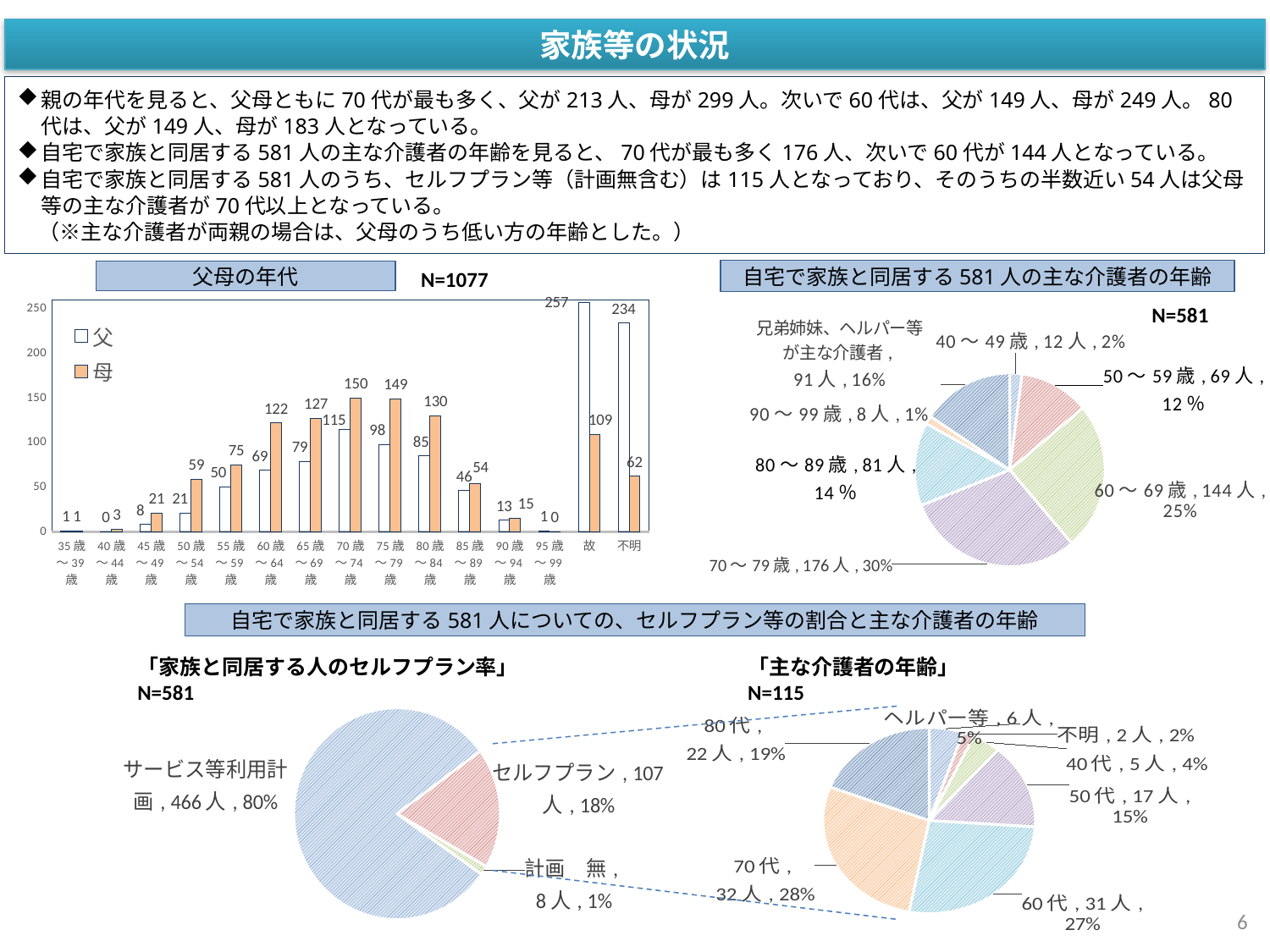
「自宅で家族と同居する581人の主な介護者の年齢」の円グラフで、80～89歳の人数はいくつですか？ 81人 「自宅で家族と同居する581人の主な介護者の年齢」の円グラフで、最も割合が大きい区分はどれですか？ 70～79歳 「父母の年代」のグラフはどの種類のグラフですか？ 棒グラフ 「家族と同居する人のセルフプラン率」の円グラフで、セルフプランの人数はいくつですか？ 107人 「主な介護者の年齢」（N=115）の円グラフで、60代の割合は何％ですか？ 27% 「父母の年代」のグラフで、「故」の父と母ではどちらの人数が多いですか？ 父 「父母の年代」のグラフで、70歳～74歳の母の人数はいくつですか？ 150 「父母の年代」のグラフで、60歳～64歳の母と父の人数の差はいくつですか？ 53 「自宅で家族と同居する581人の主な介護者の年齢」の円グラフで、60～69歳の割合は何％ですか？ 25% 「父母の年代」のグラフで、凡例にはいくつの系列がありますか？ 2 「父母の年代」のグラフで、75歳～79歳の父の人数はいくつですか？ 98 「主な介護者の年齢」（N=115）の円グラフで、最も人数が少ない区分はどれですか？ 不明